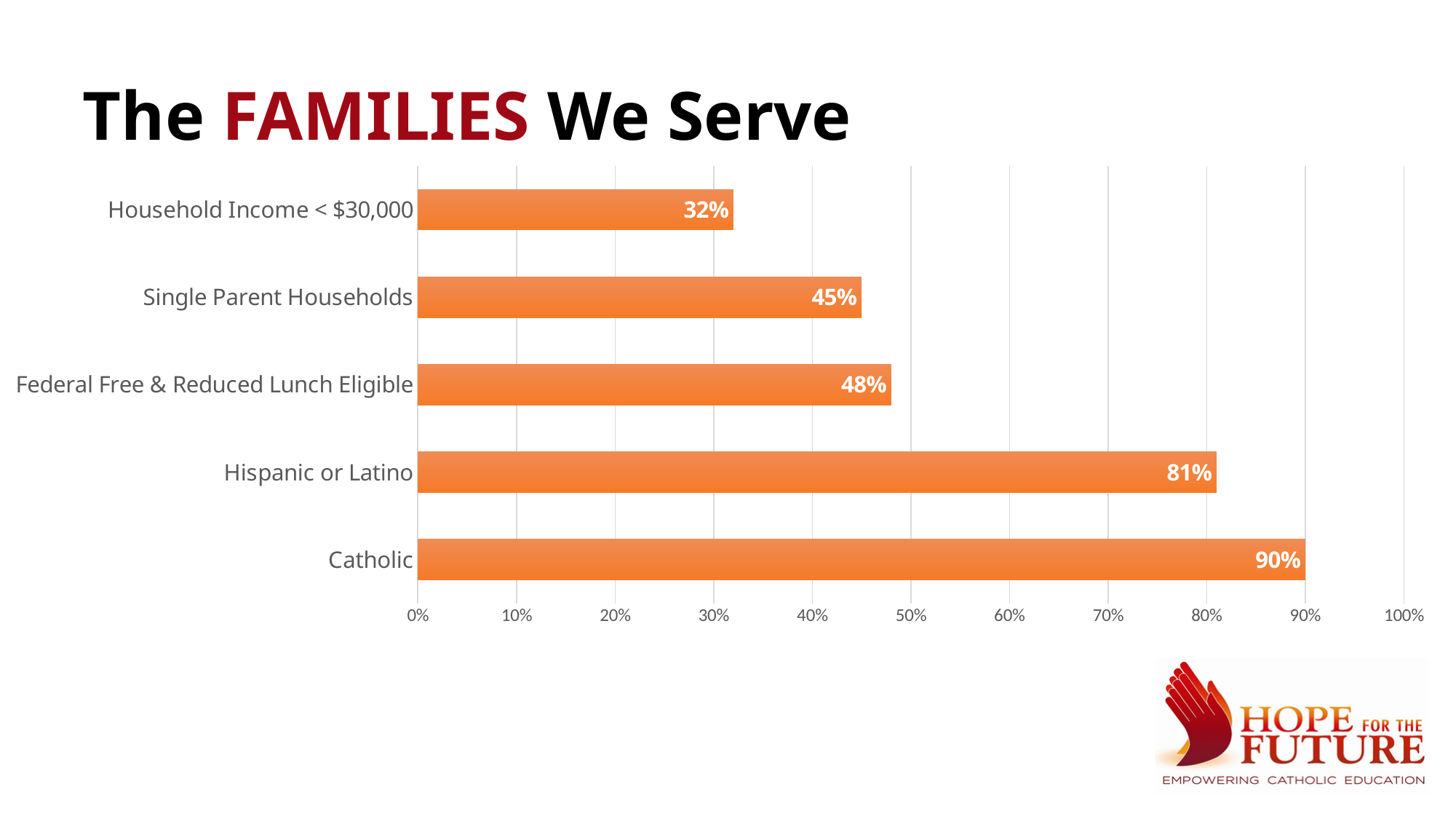
What kind of chart is shown on the slide? Bar chart How many categories are shown in the chart? 5 What is the difference between the Catholic and Hispanic or Latino values? 9% What is the difference between Federal Free & Reduced Lunch Eligible and Single Parent Households? 3% What is the value for Single Parent Households? 45% What percentage of families served are Catholic? 90% What percentage of families are Federal Free & Reduced Lunch Eligible? 48% Which is larger: Hispanic or Latino or Single Parent Households? Hispanic or Latino Which category has the highest value? Catholic Which category has the lowest value? Household Income < $30,000 What is the value for Hispanic or Latino? 81% What percentage of families have a Household Income < $30,000? 32%